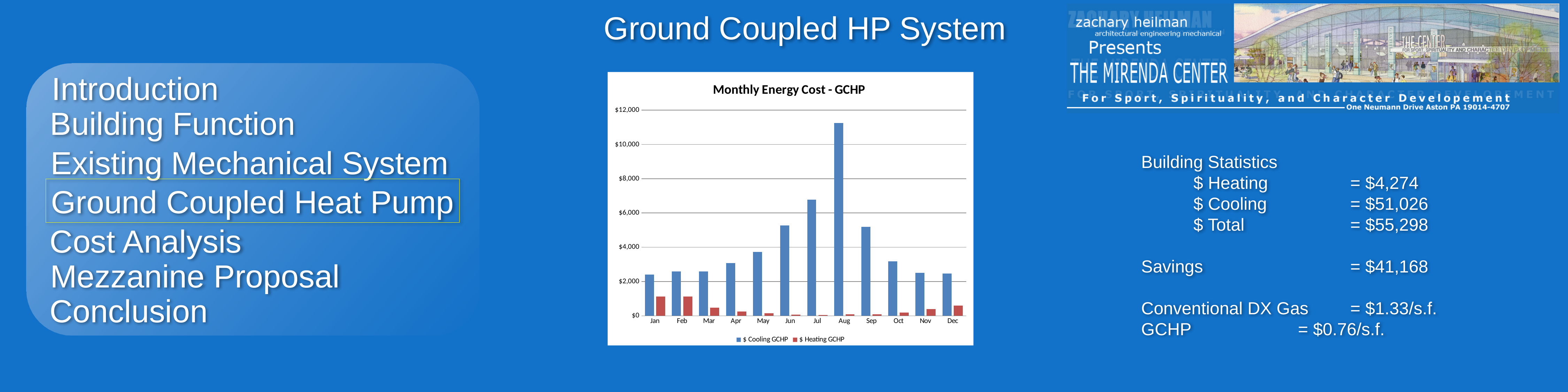
Is the $ Cooling GCHP value for Apr greater or less than $2,000? greater How many series does the chart's legend list? 2 Which colour represents the $ Heating GCHP series in the chart? Red Which month has the larger $ Cooling GCHP value, Jul or Sep? Jul Is the $ Cooling GCHP value for Jul greater or less than $6,000? greater Is the $ Heating GCHP value for Jan greater or less than $2,000? less Which month has the highest $ Cooling GCHP value? Aug What kind of chart is shown on the slide? Bar chart What is the title of the chart? Monthly Energy Cost - GCHP How many months are shown along the x axis of the chart? 12 Which is larger in Jan, the $ Cooling GCHP value or the $ Heating GCHP value? $ Cooling GCHP